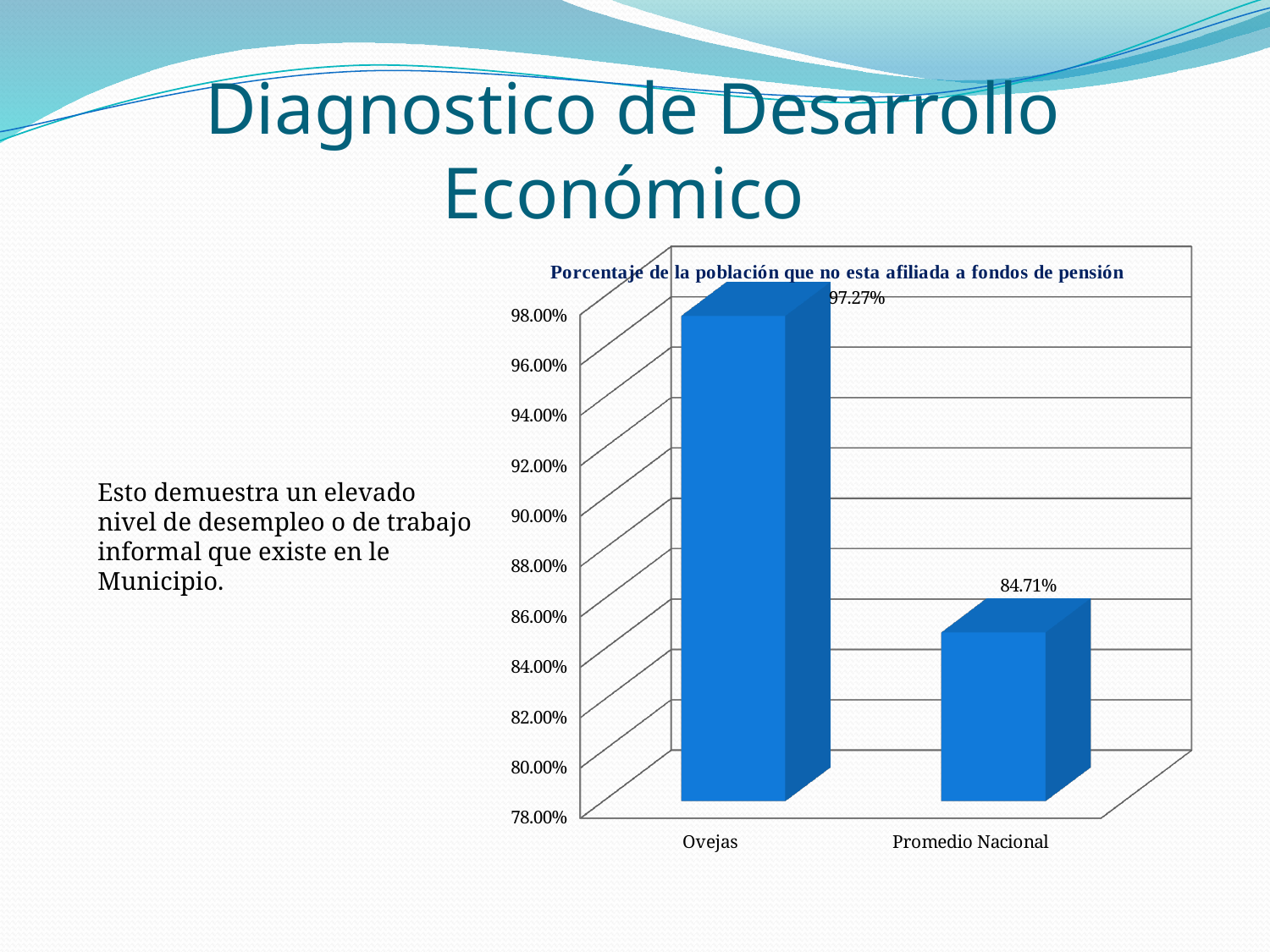
Is the value for Promedio Nacional greater or less than 90.00%? less What is the difference between the values for Ovejas and Promedio Nacional? 12.56% Which is larger, the value for Ovejas or the value for Promedio Nacional? Ovejas Is the value for Ovejas greater or less than 96.00%? greater What is the value for Promedio Nacional? 84.71% Which category has the highest value? Ovejas Which category has the lowest value? Promedio Nacional What is the lowest value shown on the vertical axis? 78.00% What is the title of the chart? Porcentaje de la población que no esta afiliada a fondos de pensión What kind of chart is shown on the slide? Bar chart How many categories are shown in the chart? 2 What is the value for Ovejas? 97.27%